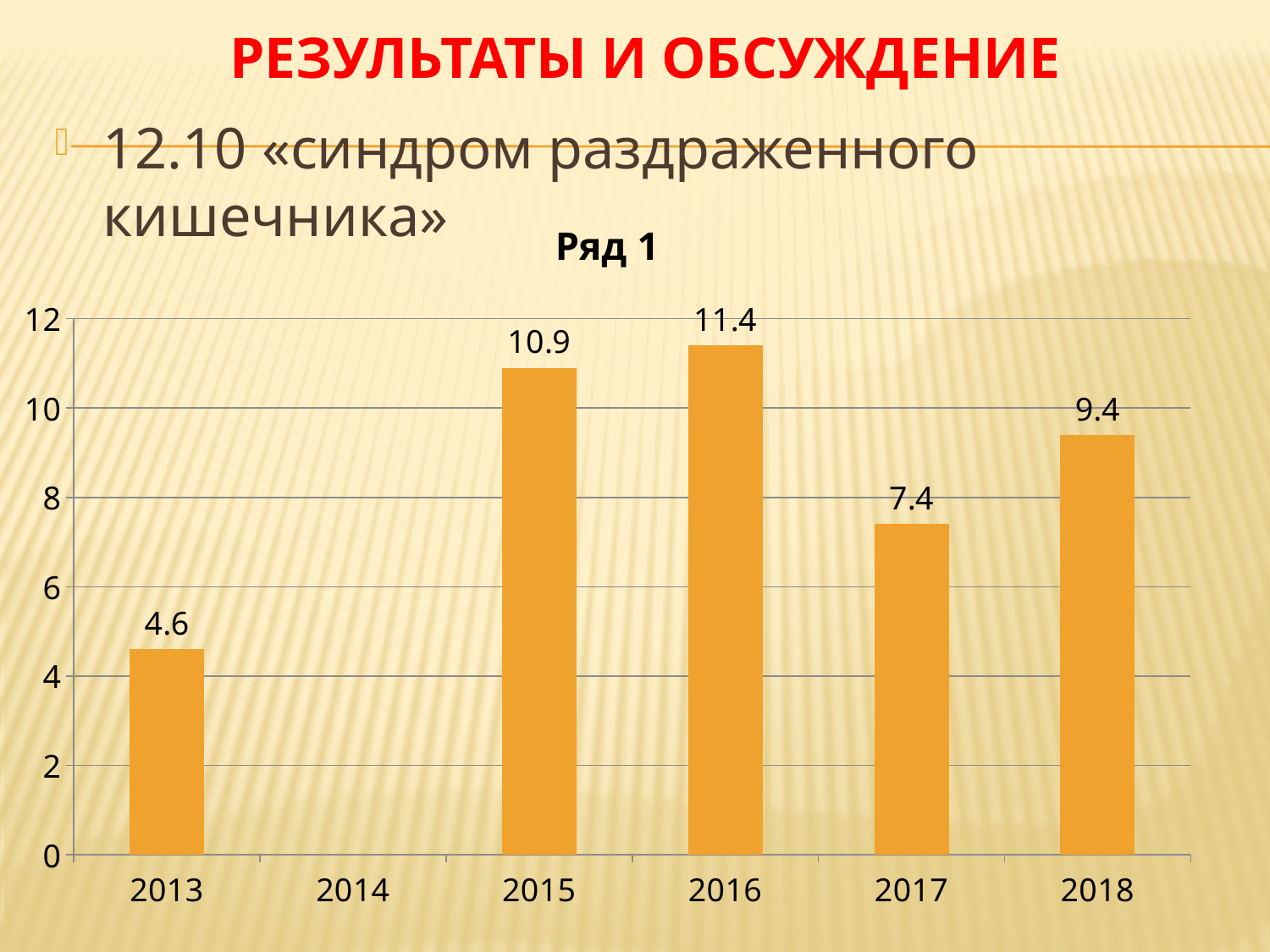
Which is larger, the value for 2015 or the value for 2018? 2015 What kind of chart is shown on the slide? bar chart What is the difference between the values for 2016 and 2015? 0.5 How many years are shown on the x axis? 6 What is the value for 2018? 9.4 What is the value for 2013? 4.6 Which year with a bar has the lowest value? 2013 Which year has the highest value? 2016 What is the value for 2016? 11.4 What is the title of the chart? Ряд 1 What is the value for 2017? 7.4 What is the difference between the values for 2018 and 2017? 2